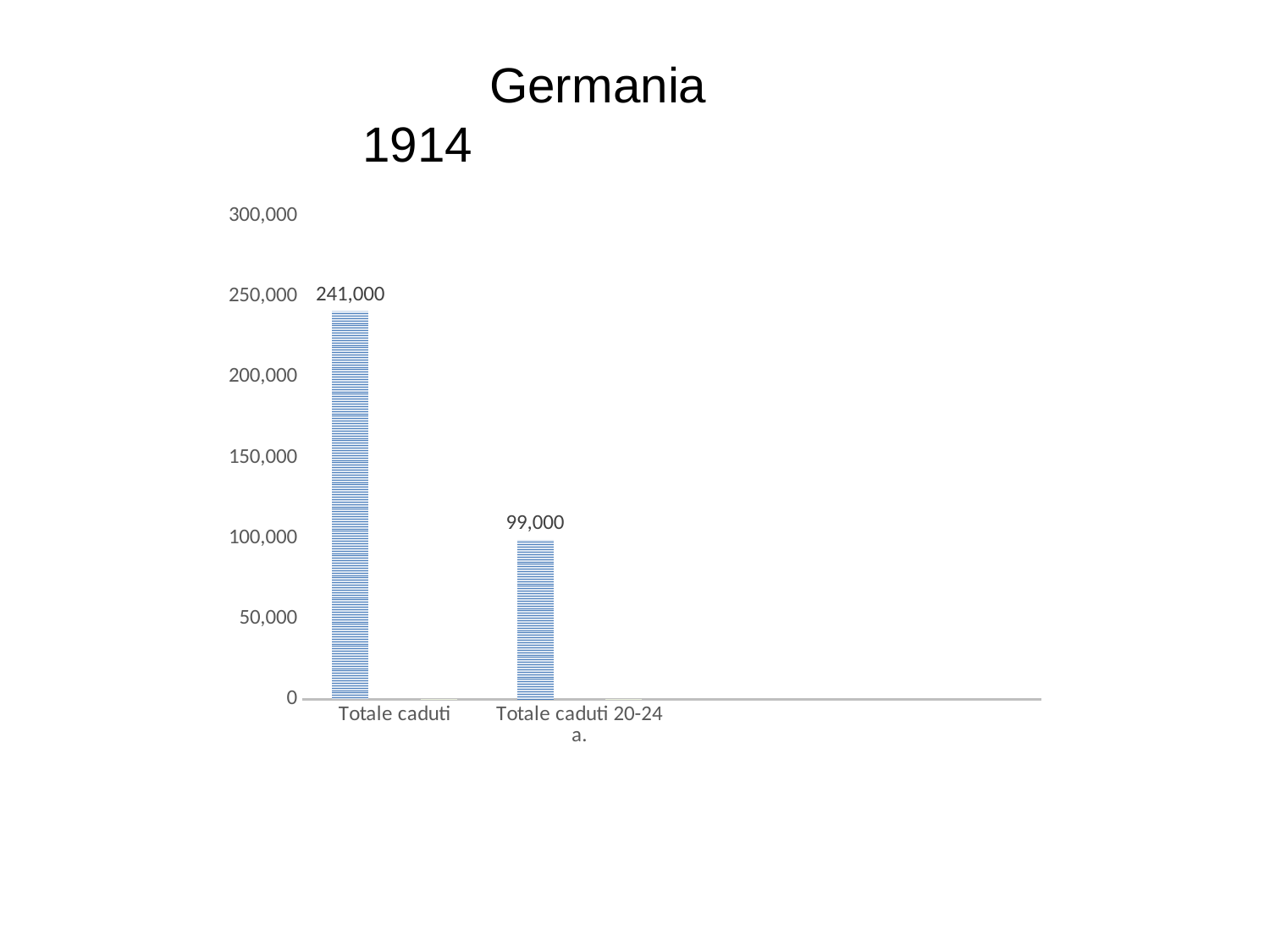
What is the value for Totale caduti? 241,000 How many categories are shown in the chart? 2 Which category has the lowest value? Totale caduti 20-24 a. What is the value for Totale caduti 20-24 a.? 99,000 What year is shown in the slide heading above the chart? 1914 Is the value for Totale caduti 20-24 a. greater or less than 100,000? less What kind of chart is shown on the slide? bar chart Which category has the highest value? Totale caduti What is the difference between the values for Totale caduti and Totale caduti 20-24 a.? 142,000 Which is larger, the value for Totale caduti or the value for Totale caduti 20-24 a.? Totale caduti What is the highest value shown on the vertical axis? 300,000 Is the value for Totale caduti greater or less than 200,000? greater